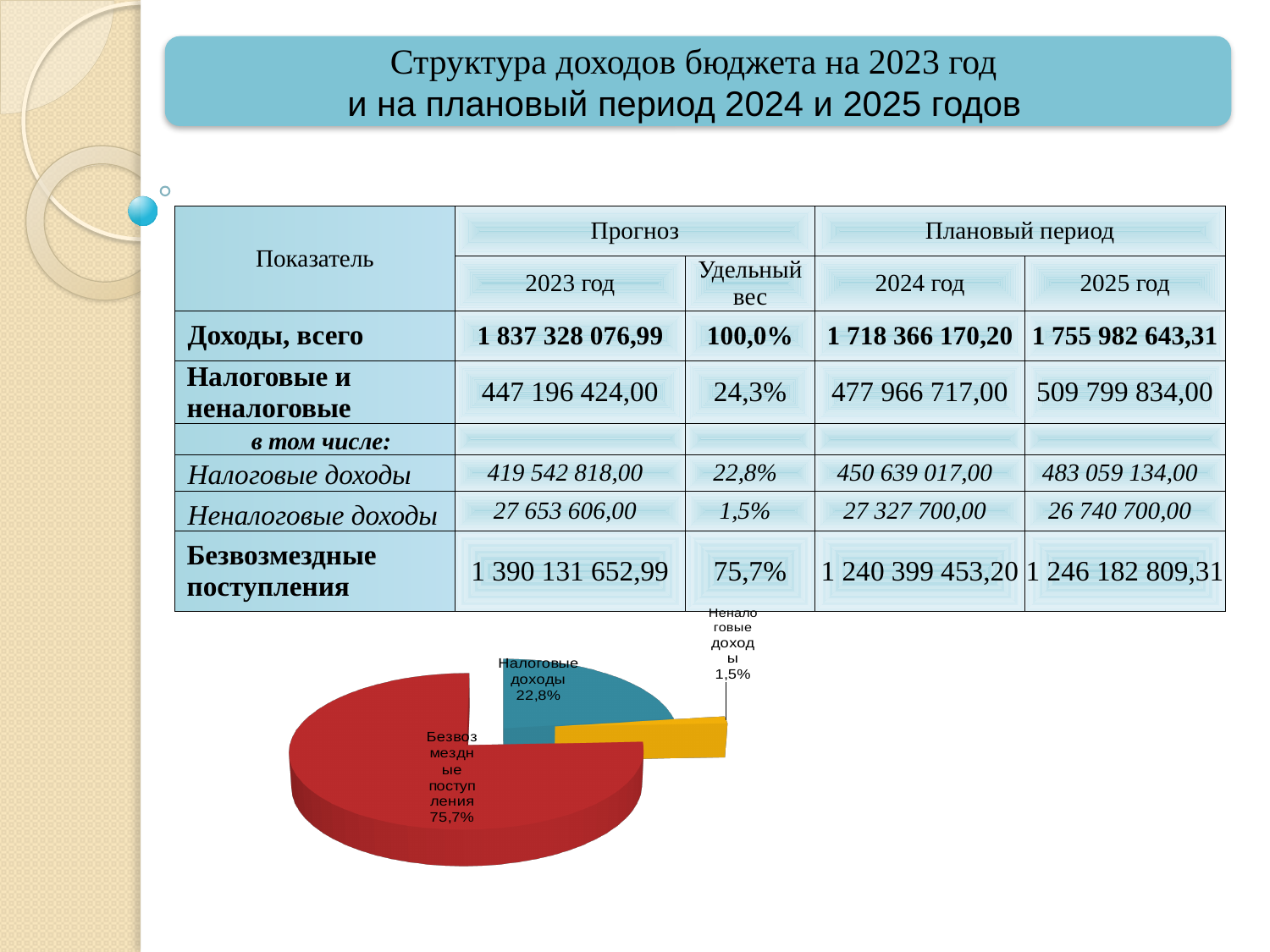
What colour is the Неналоговые доходы slice in the pie chart? yellow What share of the pie chart is labelled for Налоговые доходы? 22,8% How many slices does the pie chart have? 3 What share of the pie chart is labelled for Неналоговые доходы? 1,5% In the pie chart, which is larger: Налоговые доходы or Неналоговые доходы? Налоговые доходы Which slice of the pie chart is the largest? Безвозмездные поступления Which slice of the pie chart is the smallest? Неналоговые доходы What is the difference in percentage points between the Налоговые доходы slice and the Неналоговые доходы slice in the pie chart? 21,3 What share of the pie chart is labelled for Безвозмездные поступления? 75,7% What kind of chart is shown on the slide? pie chart What is the difference in percentage points between the Безвозмездные поступления slice and the Налоговые доходы slice in the pie chart? 52,9 What colour is the Безвозмездные поступления slice in the pie chart? red